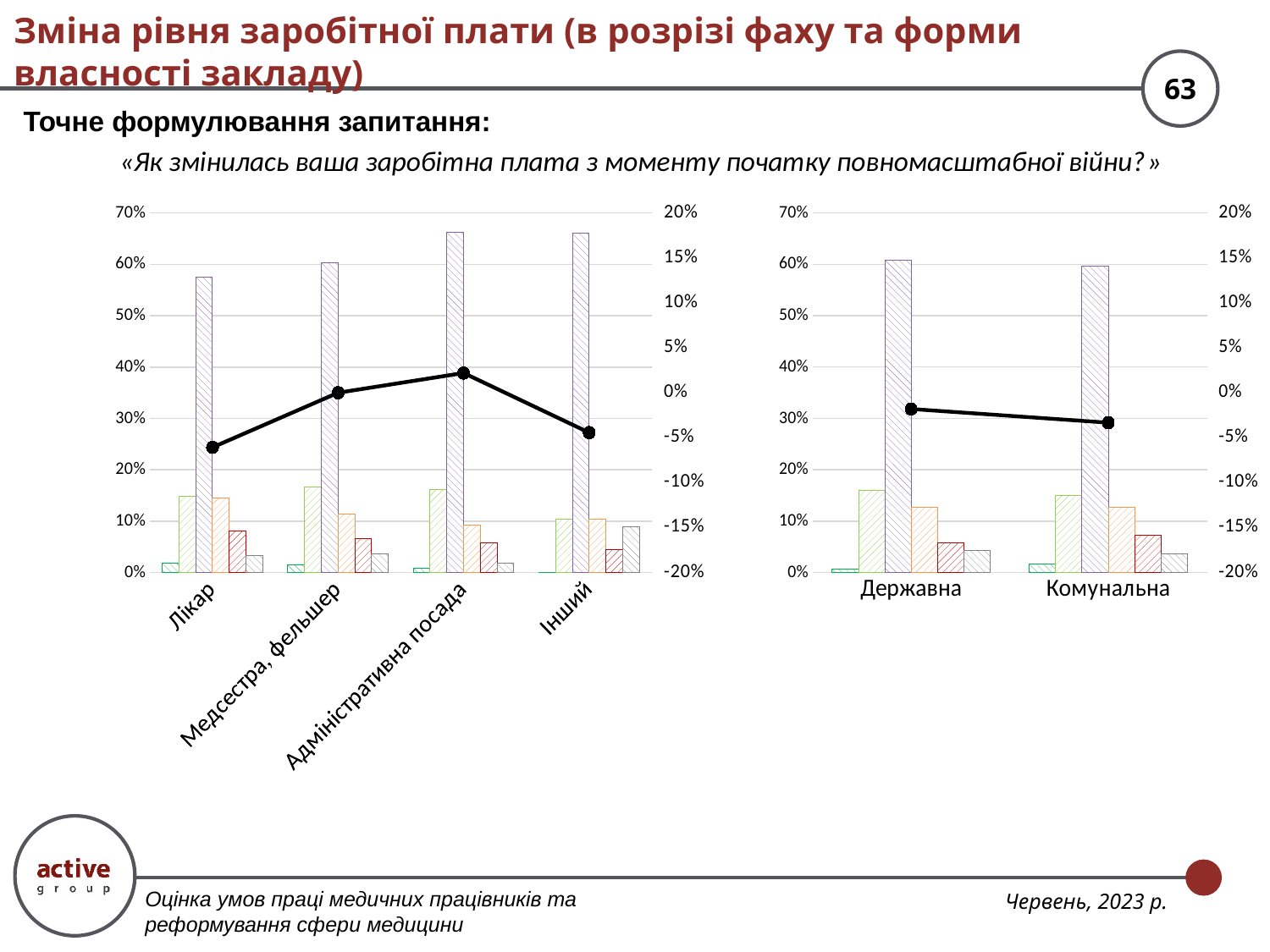
In the right chart, does the black line rise or fall from Державна to Комунальна? fall In the left chart, is the tallest bar for Лікар greater or less than 50%? greater What are the two category labels on the x axis of the right chart? Державна, Комунальна How many categories are shown on the x axis of the right chart? 2 In the right chart, is the line value for Комунальна (right axis) greater or less than 0%? less What kind of chart is the left chart? bar chart with a line In the left chart, which category has the highest point on the black line? Адміністративна посада How many categories are shown on the x axis of the left chart? 4 In the right chart, is the tallest bar for Державна greater or less than 50%? greater In the left chart, is the tallest bar for Лікар or for Адміністративна посада higher? Адміністративна посада